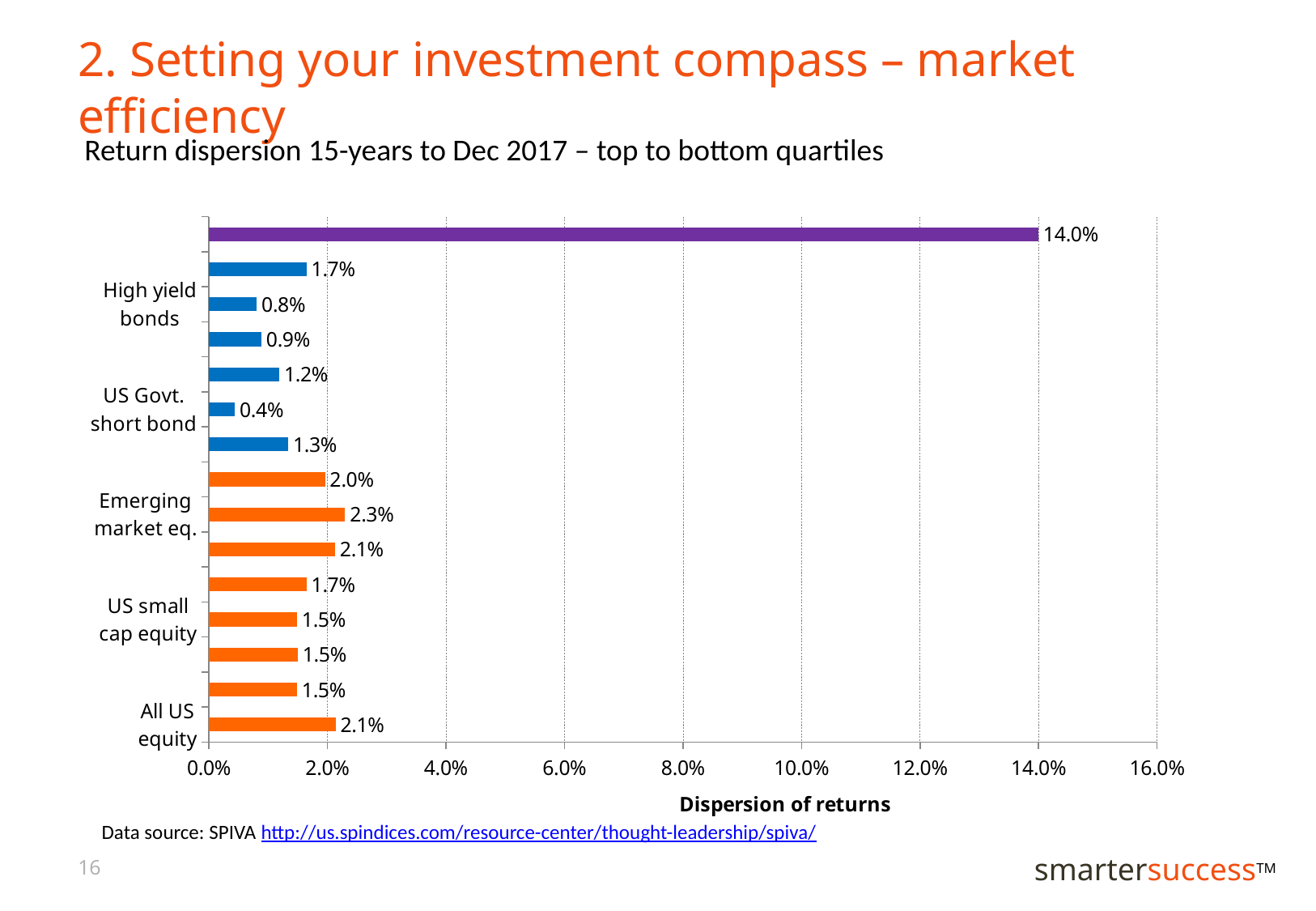
Which is larger, the bar labelled 2.3% or the bar labelled 0.9%? 2.3% What is the lowest value labelled on any bar in the chart? 0.4% What is the highest value labelled on any bar in the chart? 14.0% How many bars have a labelled value greater than 2.0%? 4 How many bars are plotted in the chart? 15 What is the chart's title text above the plot? Return dispersion 15-years to Dec 2017 – top to bottom quartiles What type of chart is shown on the slide? bar chart What is the difference between the highest labelled value (14.0%) and the lowest labelled value (0.4%)? 13.6% How many bars are labelled 1.5%? 3 What is the title of the x axis? Dispersion of returns Is the value of the longest bar greater or less than 12.0%? greater What is the largest tick value shown on the x axis? 16.0%